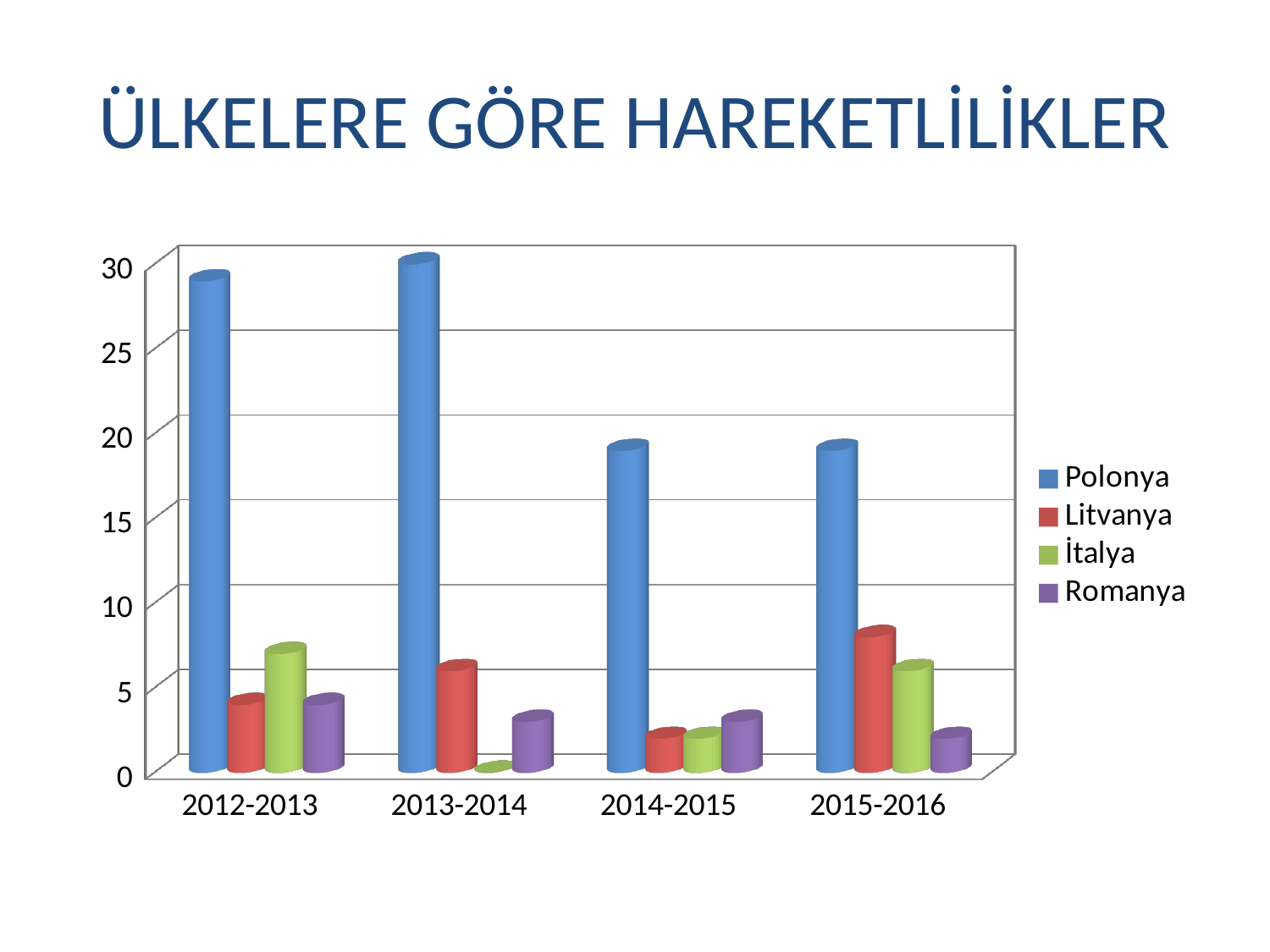
Is the value for Polonya in 2012-2013 greater or less than 25? greater Is the value for İtalya in 2012-2013 greater or less than 5? greater Which is larger in 2012-2013, İtalya or Romanya? İtalya Which is larger in 2015-2016, Litvanya or Romanya? Litvanya Which series has the lowest value in 2013-2014? İtalya What is the title of the chart? ÜLKELERE GÖRE HAREKETLİLİKLER Is the value for Polonya in 2015-2016 higher or lower than in 2012-2013? lower What kind of chart is shown on the slide? bar chart How many series does the legend list? 4 Is the value for Litvanya in 2015-2016 greater or less than 10? less Which series has the highest value in 2013-2014? Polonya How many academic-year categories are shown on the x axis? 4